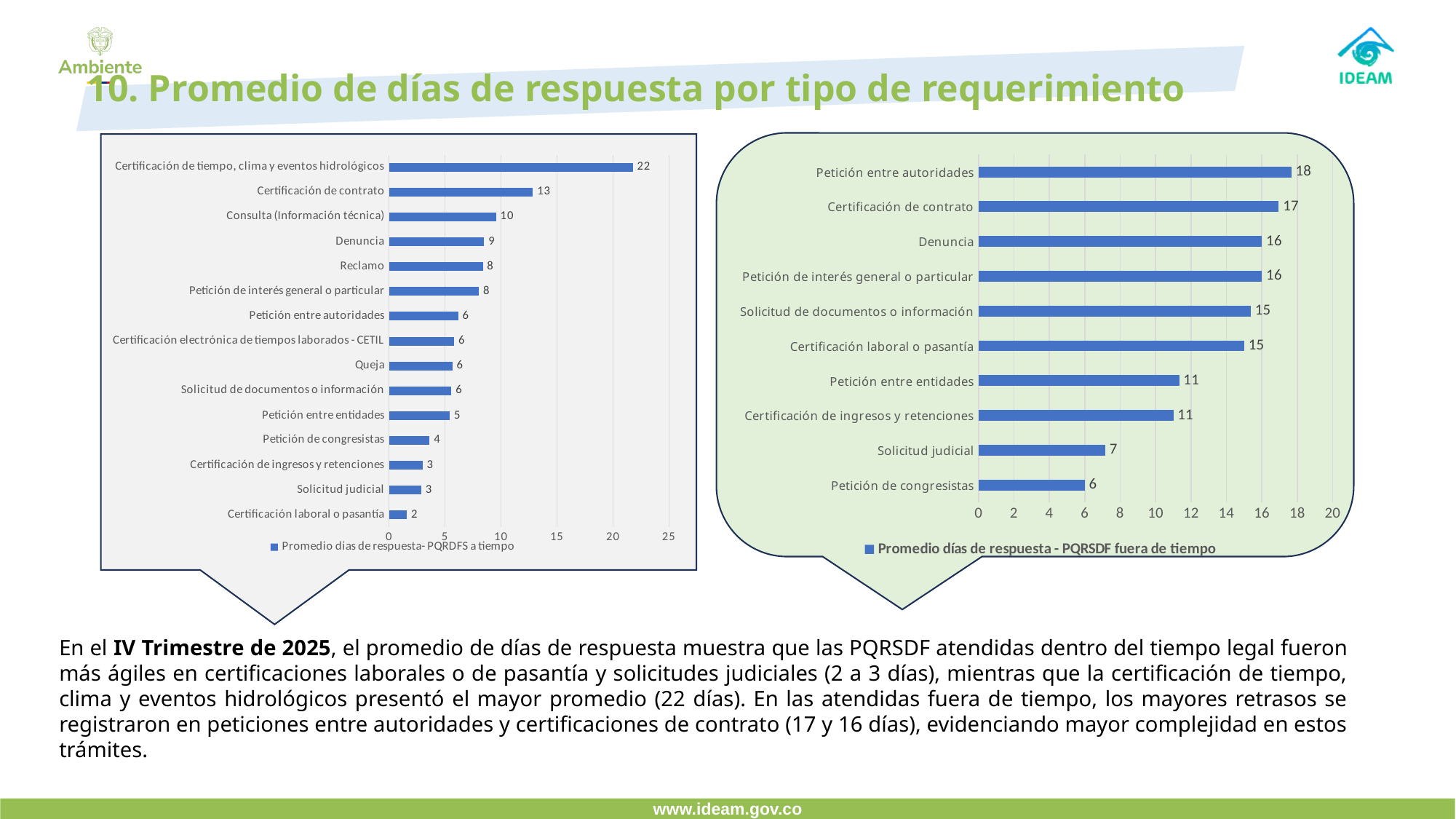
In the right chart (PQRSDF fuera de tiempo), which category has the lowest value? Petición de congresistas In the right chart (PQRSDF fuera de tiempo), which is larger: Certificación de contrato or Petición entre entidades? Certificación de contrato In the right chart (PQRSDF fuera de tiempo), which category has the highest value? Petición entre autoridades In the left chart (PQRDFS a tiempo), how many categories are plotted? 15 In the right chart (PQRSDF fuera de tiempo), how many categories are plotted? 10 In the right chart (PQRSDF fuera de tiempo), what is the value for Solicitud judicial? 7 In the left chart (PQRDFS a tiempo), which category has the highest value? Certificación de tiempo, clima y eventos hidrológicos In the left chart (PQRDFS a tiempo), what is the value for Certificación de contrato? 13 In the left chart (PQRDFS a tiempo), what is the difference between Certificación de tiempo, clima y eventos hidrológicos and Consulta (Información técnica)? 12 What is the legend entry of the left chart? Promedio dias de respuesta- PQRDFS a tiempo In the left chart (PQRDFS a tiempo), which category has the lowest value? Certificación laboral o pasantía What kind of chart is the right chart (PQRSDF fuera de tiempo)? Bar chart